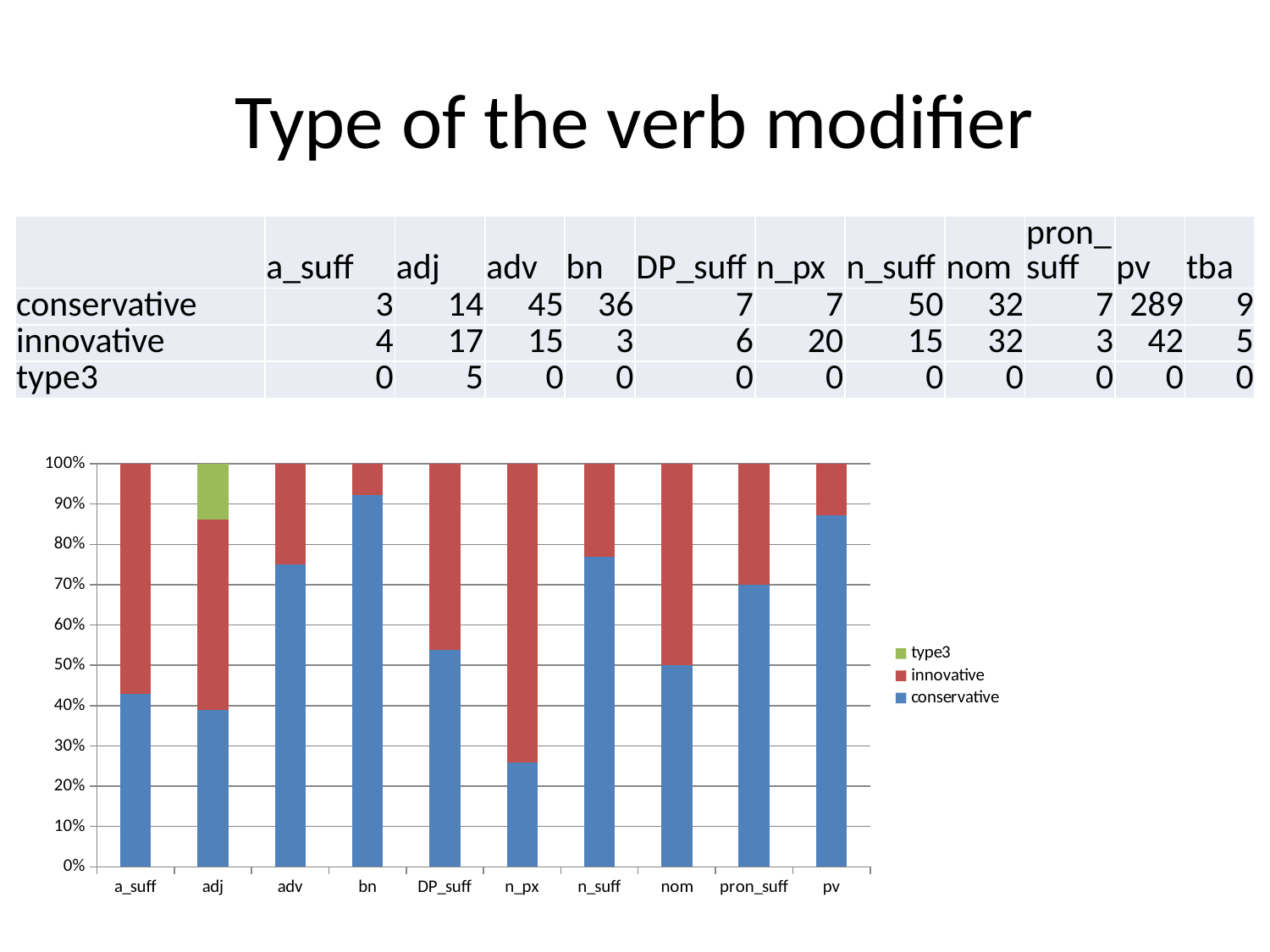
Is the conservative share for bn in the chart greater or less than 90%? greater Is the conservative share for adv in the chart greater or less than 70%? greater Is the conservative share for pv in the chart greater or less than 80%? greater Which category in the chart has the largest conservative share? bn Which category in the chart has the smallest conservative share? n_px What kind of chart is shown on the slide? stacked bar chart How many categories are shown along the x axis of the chart? 10 How many series does the chart legend list? 3 Which colour represents the innovative series in the chart? red Which category in the chart is the only one with a type3 segment? adj